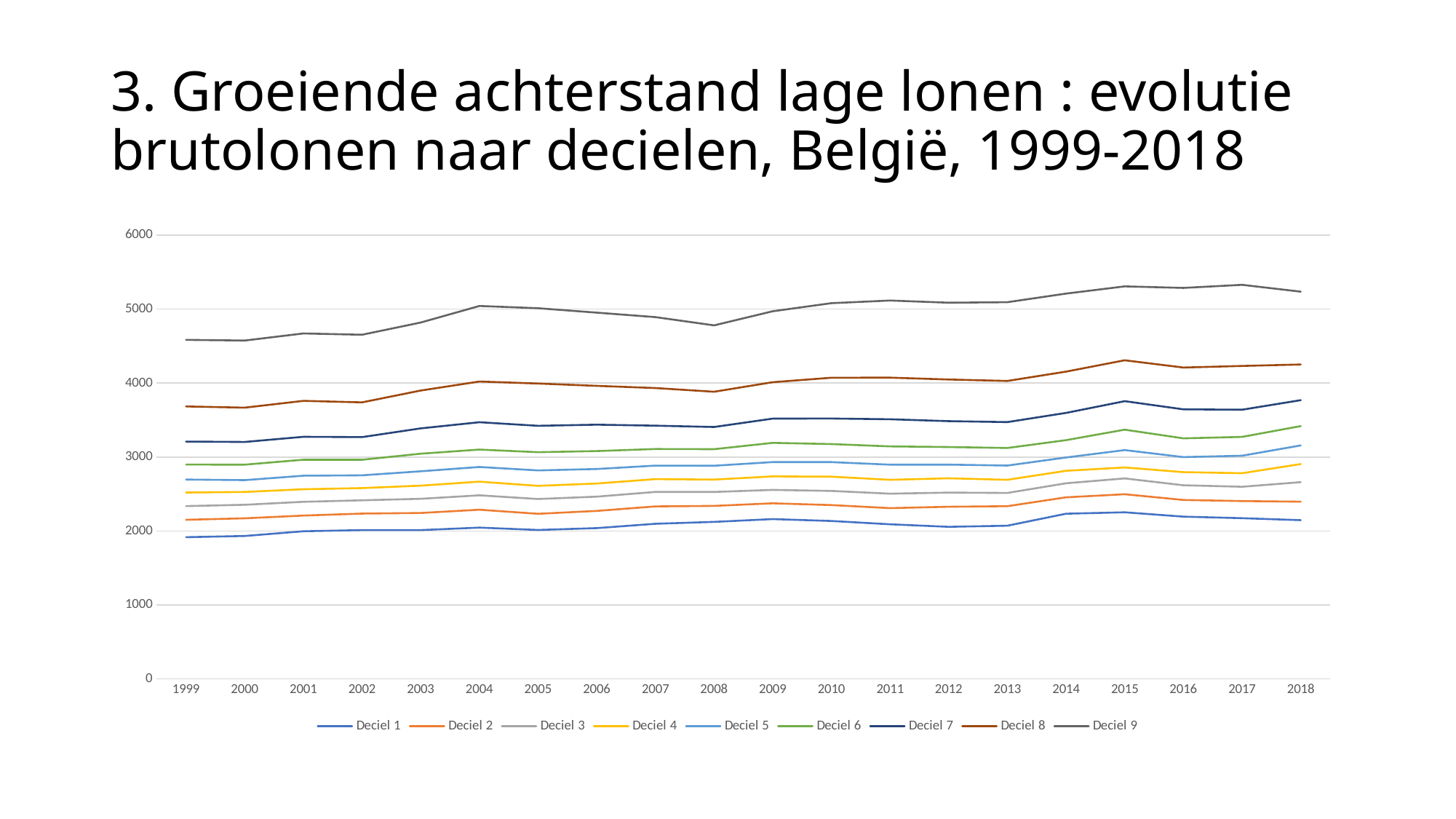
What kind of chart is shown on the slide? line chart How many years are plotted along the x axis? 20 Is the value for Deciel 9 in 2018 greater or less than 5000? greater Which series has the lowest values throughout the chart? Deciel 1 Which is larger in 2018: the value for Deciel 9 or the value for Deciel 1? Deciel 9 What is the first year shown on the x axis? 1999 Is the value for Deciel 1 in 1999 greater or less than 2000? less Which series has the highest values throughout the chart? Deciel 9 Is the value for Deciel 8 in 2015 greater or less than 4000? greater Does the Deciel 9 line rise or fall overall from 1999 to 2018? rise How many series does the legend list? 9